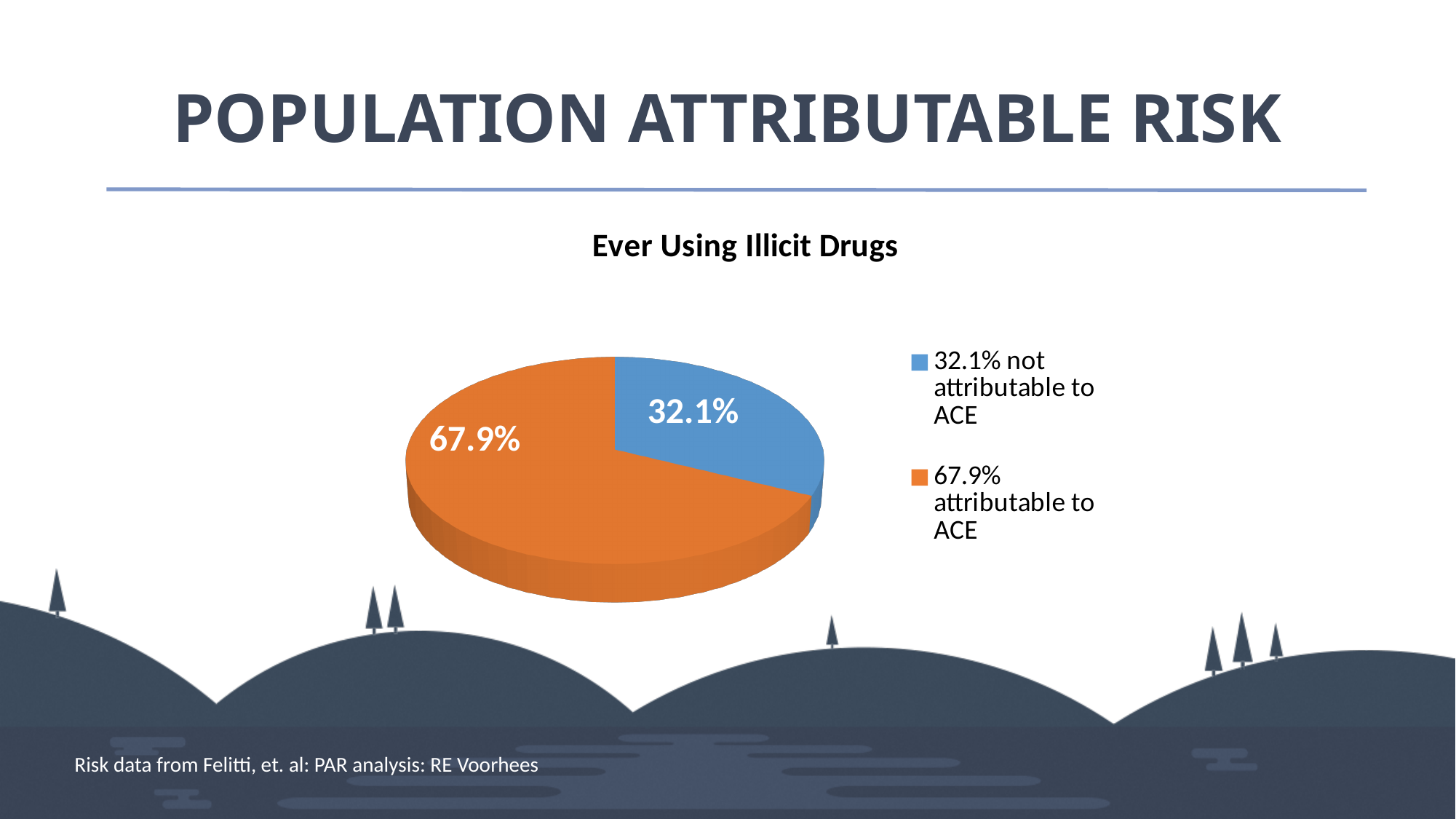
What share of the pie is attributable to ACE? 67.9% What is the total of the two slices? 100% What share of the pie is not attributable to ACE? 32.1% How many slices does the pie chart have? 2 What colour is the slice attributable to ACE? Orange What is the title of the chart? Ever Using Illicit Drugs Which slice is the smallest? 32.1% not attributable to ACE What kind of chart is shown on the slide? Pie chart Which is larger: the slice attributable to ACE or the slice not attributable to ACE? Attributable to ACE Which slice is the largest? 67.9% attributable to ACE What is the difference between the attributable to ACE slice and the not attributable to ACE slice? 35.8% How many entries does the legend list? 2